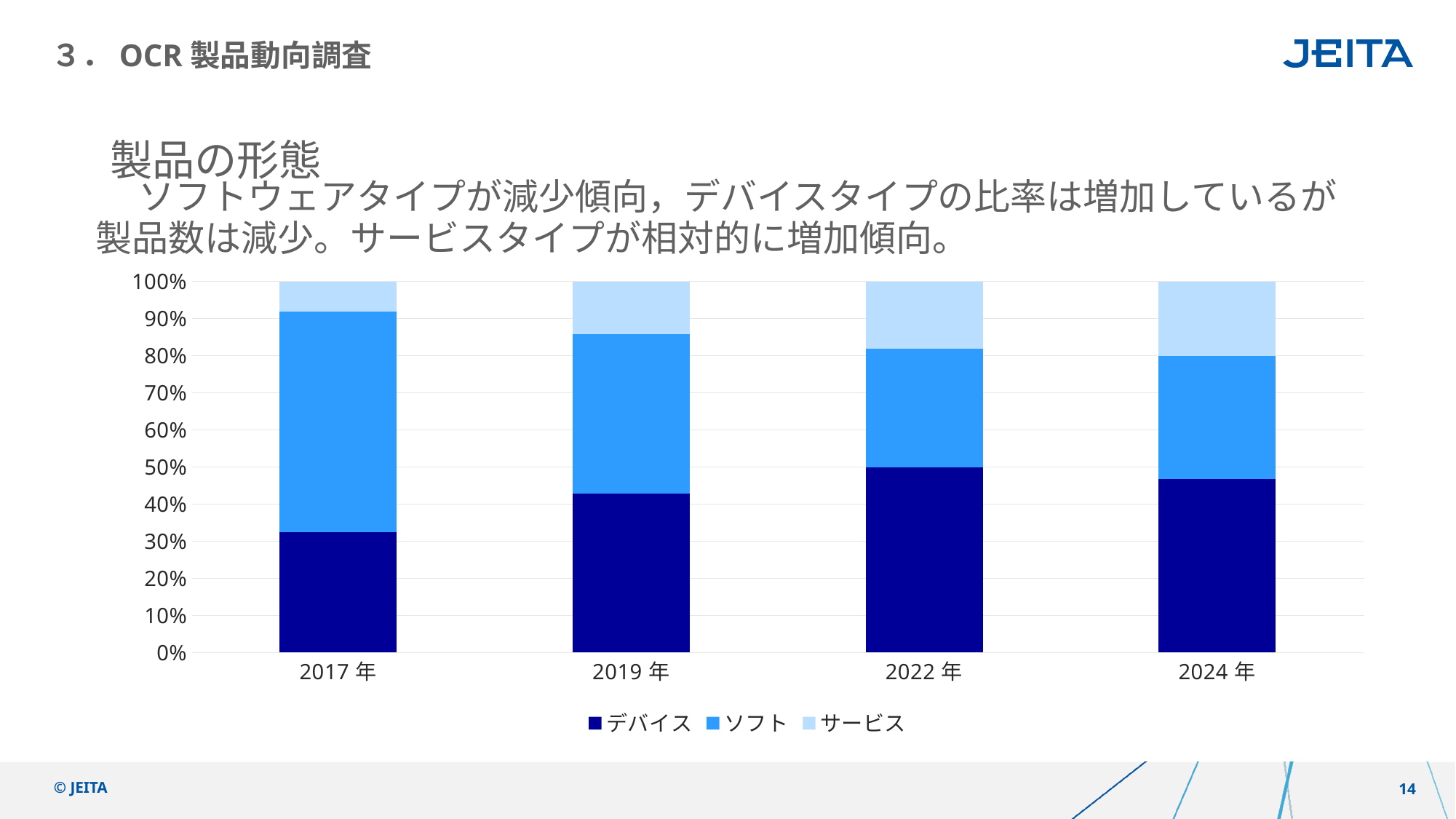
Which series is shown in the darkest blue at the bottom of each bar? デバイス Is the デバイス share for 2019年 greater or less than 40%? greater Is the デバイス share larger in 2017年 or in 2019年? 2019年 How many series does the chart legend list? 3 How many years (categories) are shown on the x axis of the chart? 4 Is the サービス share for 2024年 greater or less than 10%? greater Does the サービス share rise or fall from 2017年 to 2024年? rise Which year has the smallest デバイス share? 2017年 What kind of chart is shown on the slide? stacked bar chart Is the デバイス share for 2017年 greater or less than 40%? less What are the three series listed in the chart legend? デバイス, ソフト, サービス Which year has the smallest サービス share? 2017年